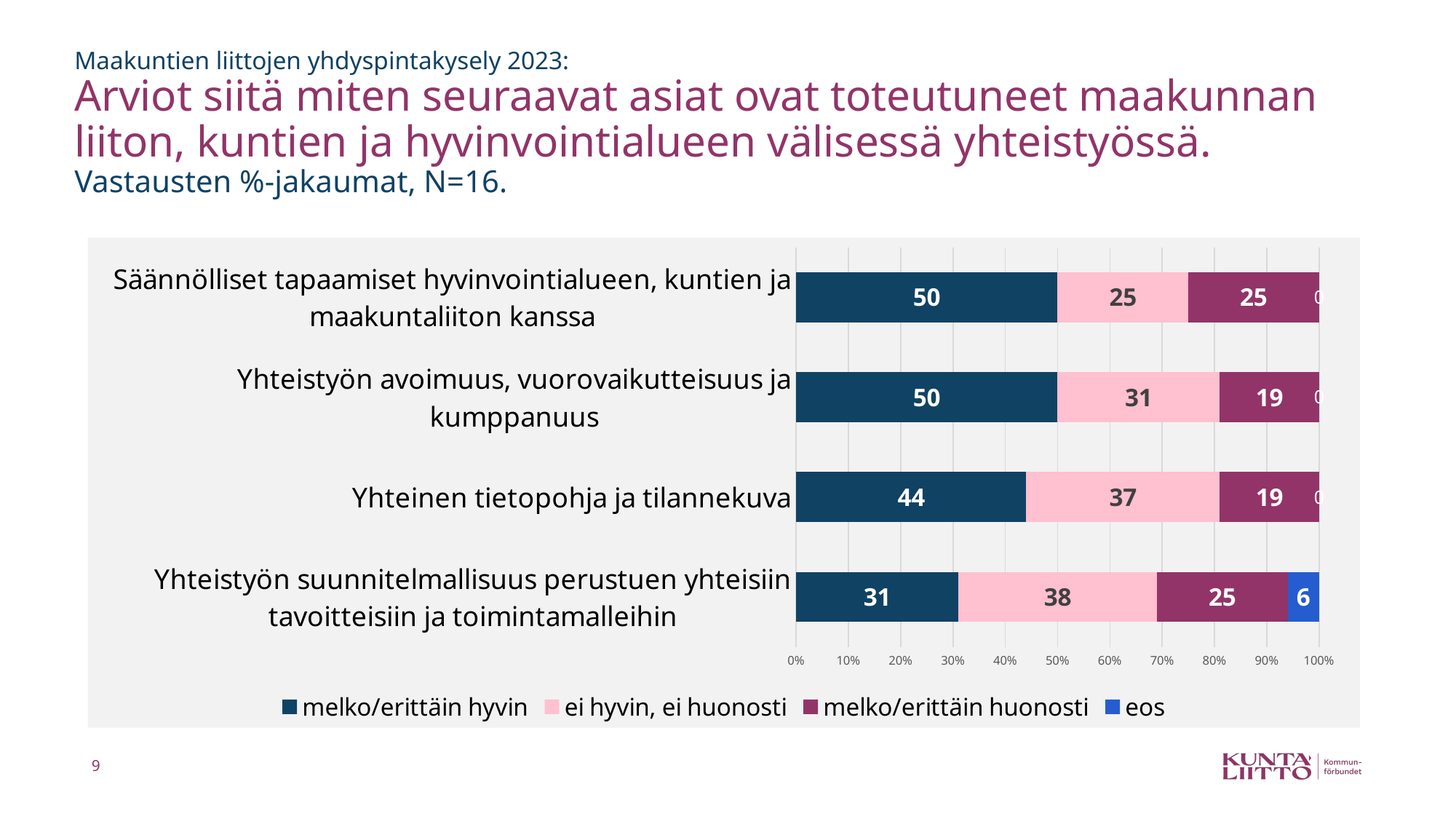
What is the difference between the "melko/erittäin hyvin" values for "Säännölliset tapaamiset hyvinvointialueen, kuntien ja maakuntaliiton kanssa" and "Yhteistyön suunnitelmallisuus perustuen yhteisiin tavoitteisiin ja toimintamalleihin"? 19 Which category has the highest value for "ei hyvin, ei huonosti"? Yhteistyön suunnitelmallisuus perustuen yhteisiin tavoitteisiin ja toimintamalleihin How many series does the legend list? 4 What is the value for "melko/erittäin huonosti" for "Yhteistyön avoimuus, vuorovaikutteisuus ja kumppanuus"? 19 What kind of chart is shown on the slide? Stacked bar chart Which series is shown in blue in the legend? eos Which category has the lowest value for "melko/erittäin hyvin"? Yhteistyön suunnitelmallisuus perustuen yhteisiin tavoitteisiin ja toimintamalleihin What is the value for "ei hyvin, ei huonosti" for "Yhteistyön suunnitelmallisuus perustuen yhteisiin tavoitteisiin ja toimintamalleihin"? 38 Which is larger: the "ei hyvin, ei huonosti" value for "Yhteinen tietopohja ja tilannekuva" or for "Yhteistyön avoimuus, vuorovaikutteisuus ja kumppanuus"? Yhteinen tietopohja ja tilannekuva What is the value for "melko/erittäin hyvin" for "Yhteinen tietopohja ja tilannekuva"? 44 How many categories (statements) are plotted in the chart? 4 What is the value for "eos" for "Yhteistyön suunnitelmallisuus perustuen yhteisiin tavoitteisiin ja toimintamalleihin"? 6